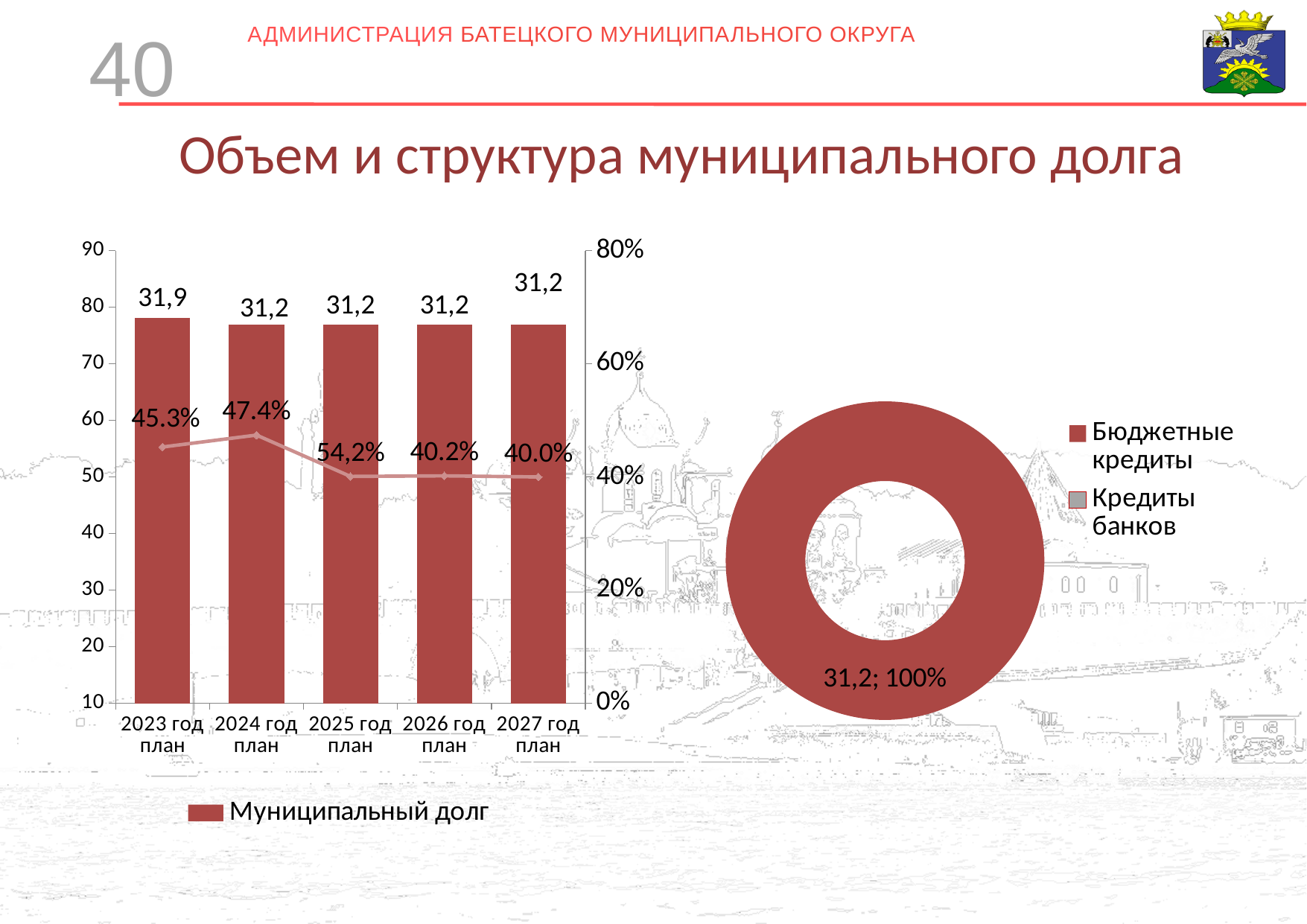
What type of chart is the chart on the right of the slide? Doughnut chart How many categories are shown on the x axis of the bar chart on the left? 5 In the bar chart on the left, what is the difference between the bar values for 2023 год план and 2024 год план? 0,7 In the bar chart on the left, what is the value of the bar for 2025 год план? 31,2 In the bar chart on the left, which category has the highest bar value? 2023 год план In the doughnut chart on the right, what share does Бюджетные кредиты have? 100% In the bar chart on the left, what is the value of the bar for 2023 год план? 31,9 How many entries does the legend of the doughnut chart on the right list? 2 In the bar chart on the left, which bar is larger: 2023 год план or 2026 год план? 2023 год план In the bar chart on the left, what percentage is shown on the line for 2024 год план? 47.4% In the bar chart on the left, for which category is the line percentage lowest? 2027 год план